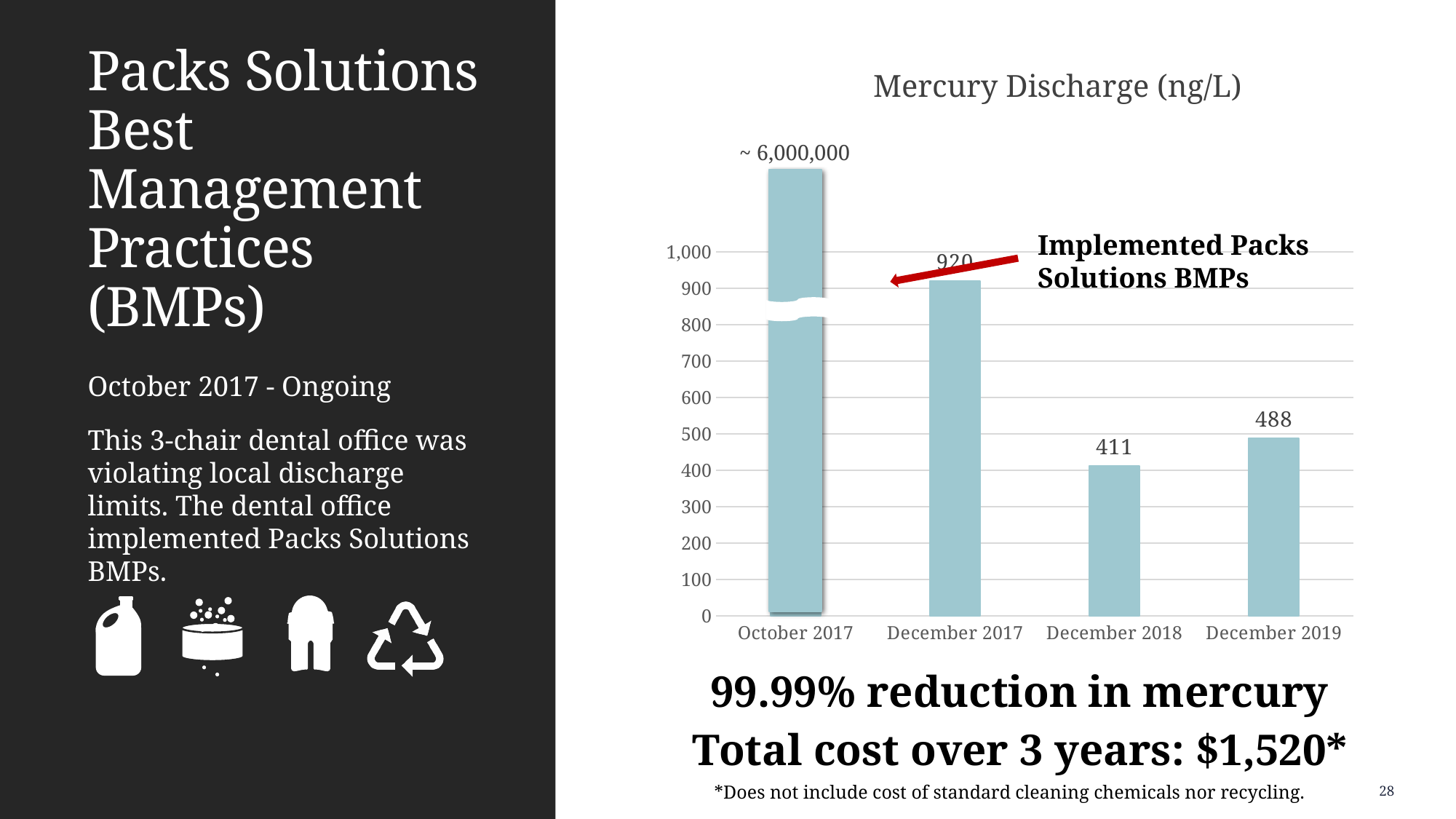
What is the mercury discharge value for December 2018? 411 What type of chart is shown on the slide? bar chart What is the mercury discharge value for December 2017? 920 What is the mercury discharge value for December 2019? 488 Is the value for December 2017 greater or less than 1,000? less What is the difference between the December 2017 and December 2018 values? 509 What is the difference between the December 2019 and December 2018 values? 77 Which category has the lowest mercury discharge? December 2018 How many categories are plotted on the x axis of the chart? 4 Which category has the highest mercury discharge? October 2017 What is the title of the chart? Mercury Discharge (ng/L) Which is larger, the value for December 2018 or December 2019? December 2019